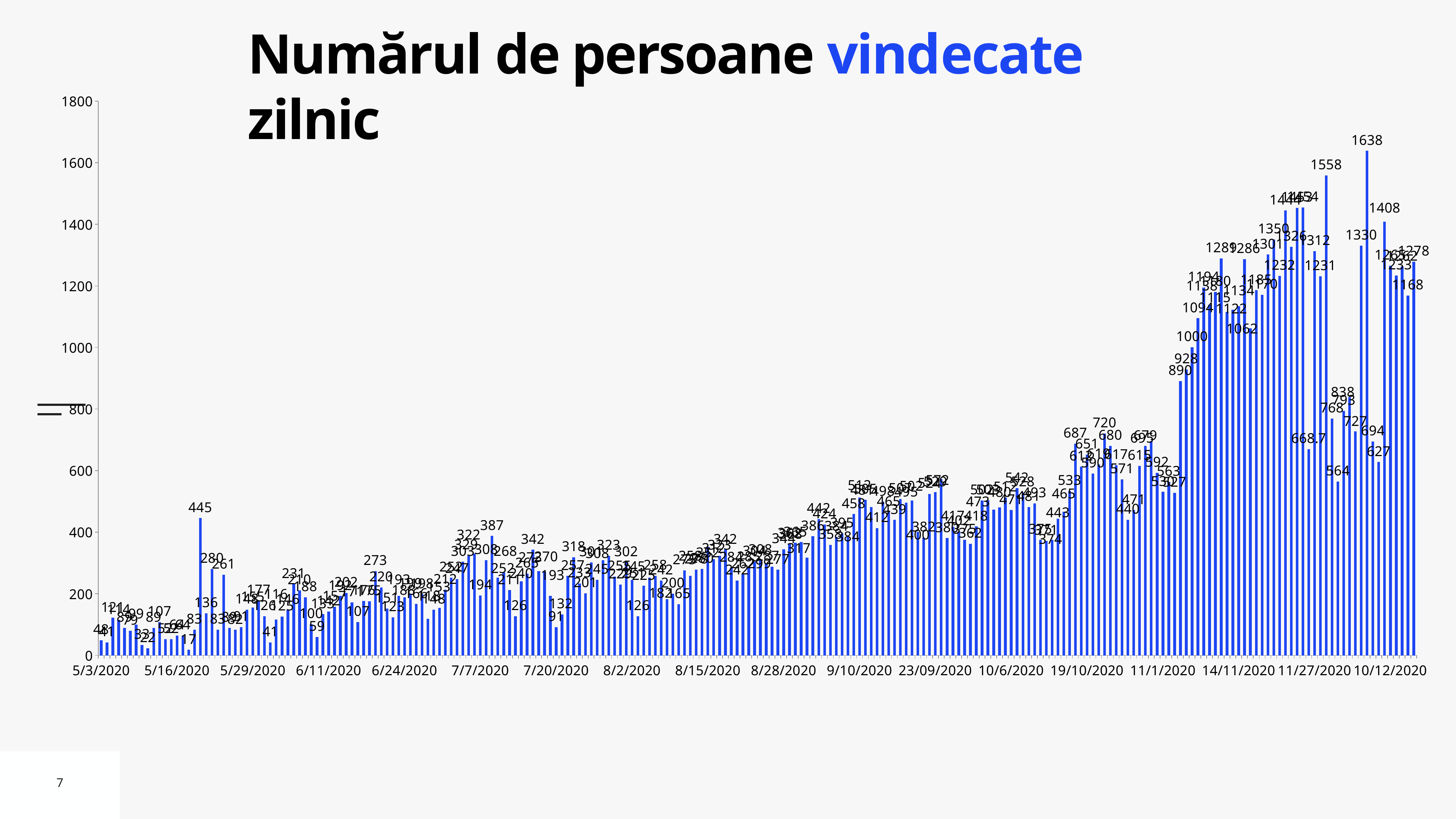
Is the value of the first bar at 5/3/2020 greater or less than 200? less What kind of chart is shown on the slide? bar chart What is the highest daily value shown on the chart? 1638 What is the title of the chart? Numărul de persoane vindecate zilnic Do the values generally rise or fall from left to right along the x axis? rise Which is larger, the bar labelled 1638 or the bar labelled 1408? 1638 What is the difference between the two highest values, 1638 and 1558? 80 Is the value of the last bar on the right of the chart greater or less than 1000? greater What is the difference between the bars labelled 1408 and 1330? 78 What is the lowest daily value labelled on the chart? 17 What is the maximum value shown on the y axis? 1800 What is the value of the tallest bar between 5/16/2020 and 5/29/2020? 445